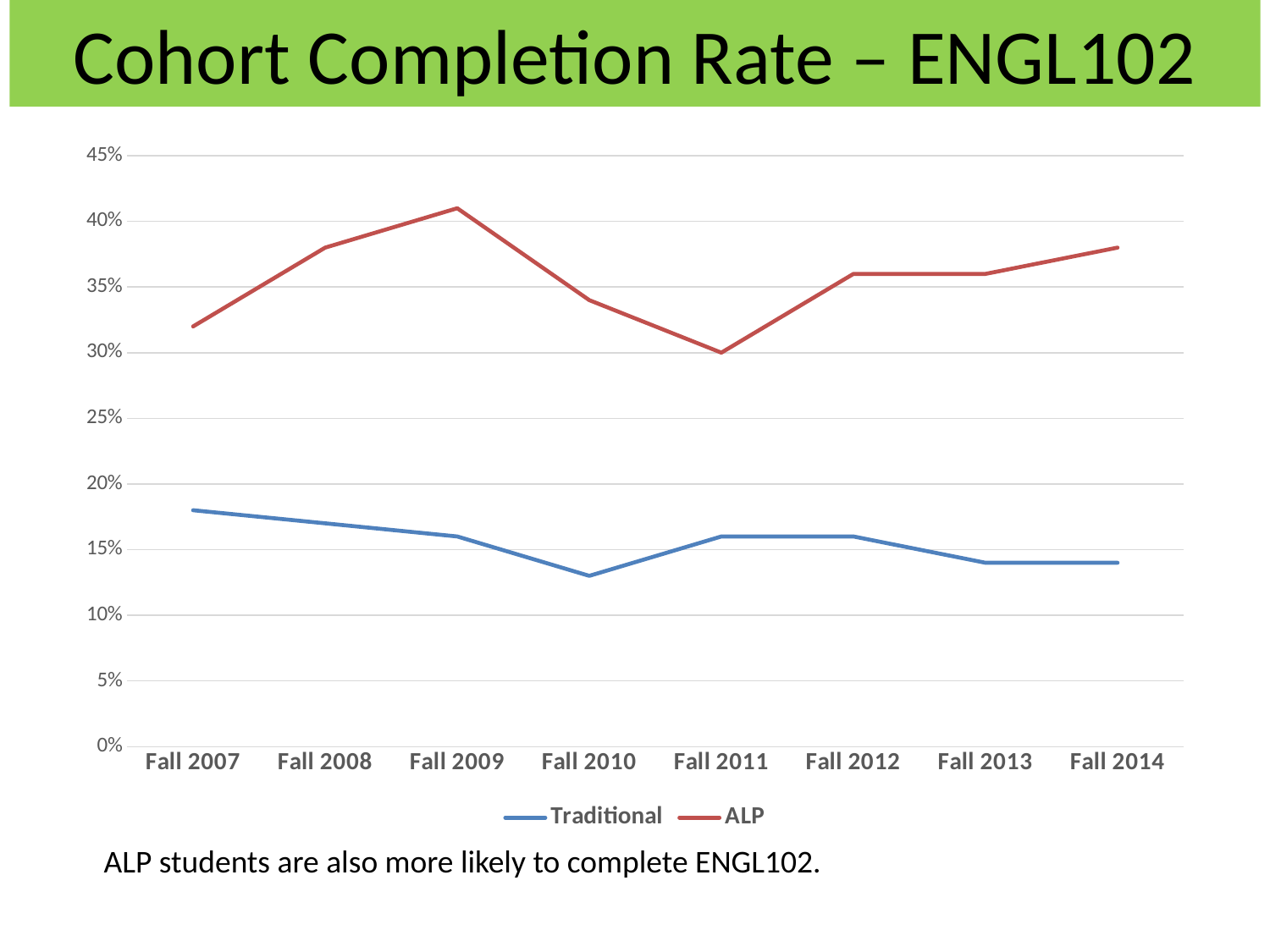
Which series has the higher value in Fall 2014, Traditional or ALP? ALP How many cohorts (points along the x axis) are plotted for each series? 8 Which series is drawn in red? ALP Is the ALP value for Fall 2009 greater or less than 40%? greater Is the Traditional value for Fall 2010 greater or less than 15%? less What is the title of the chart? Cohort Completion Rate – ENGL102 How many series does the legend list? 2 In which cohort does the Traditional series reach its highest value? Fall 2007 In which cohort does the ALP series reach its highest value? Fall 2009 In which cohort does the Traditional series reach its lowest value? Fall 2010 What type of chart is shown on the slide? line chart In which cohort does the ALP series reach its lowest value? Fall 2011